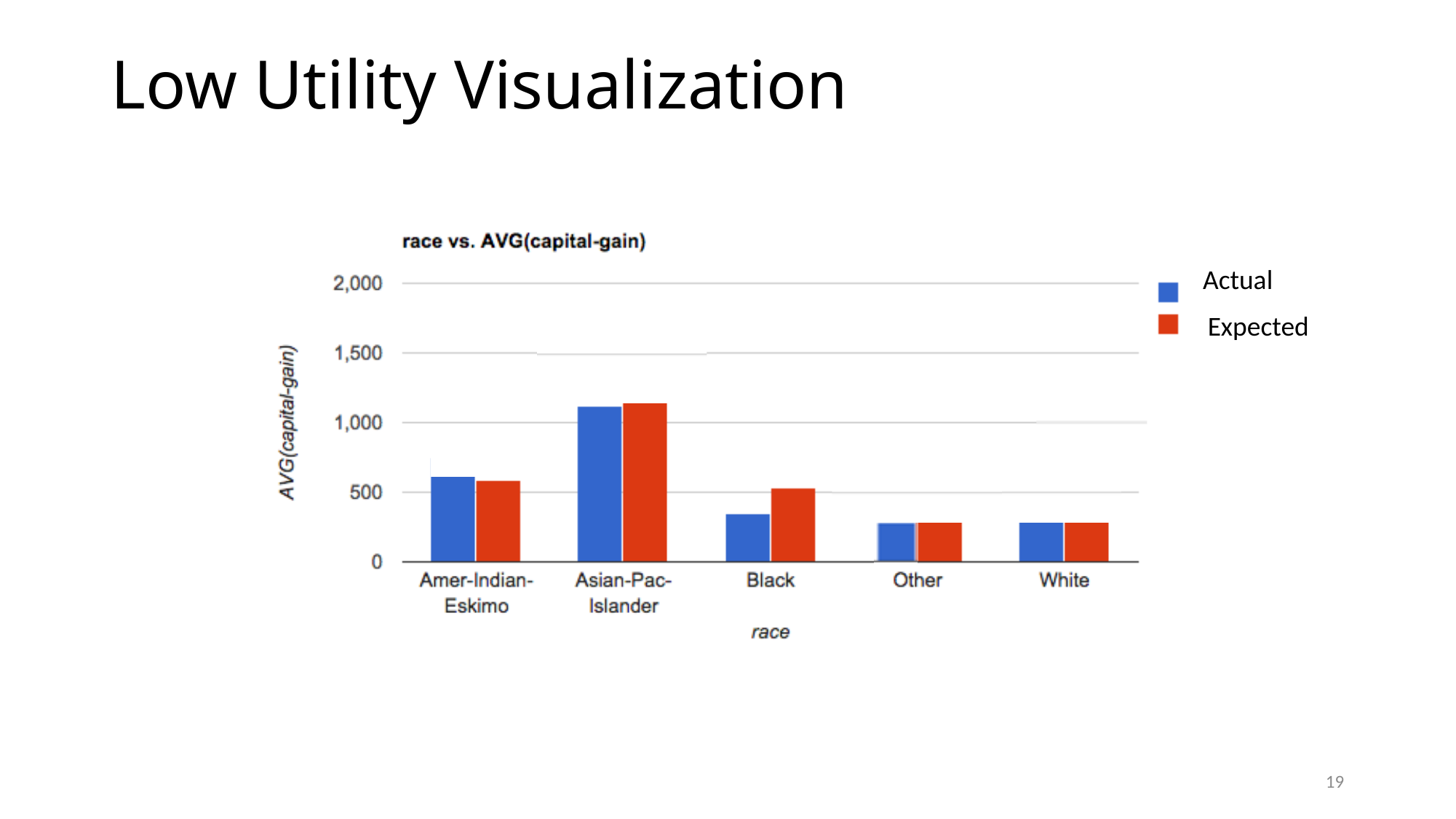
Which race category has the highest Actual value in the chart? Asian-Pac-Islander What is the title of the chart? race vs. AVG(capital-gain) Is the Actual value for Black greater or less than 500? less How many series does the legend of the chart list? 2 How many race categories are shown on the x axis of the chart? 5 Is the Actual value for Asian-Pac-Islander greater or less than 1,000? greater Which is larger: the Actual value for Asian-Pac-Islander or the Actual value for Amer-Indian-Eskimo? Asian-Pac-Islander Which series is shown in red in the chart? Expected For Black, which is larger: the Actual value or the Expected value? Expected What kind of chart is shown on the slide? bar chart Which race category has the highest Expected value in the chart? Asian-Pac-Islander Is the Expected value for Other greater or less than 500? less